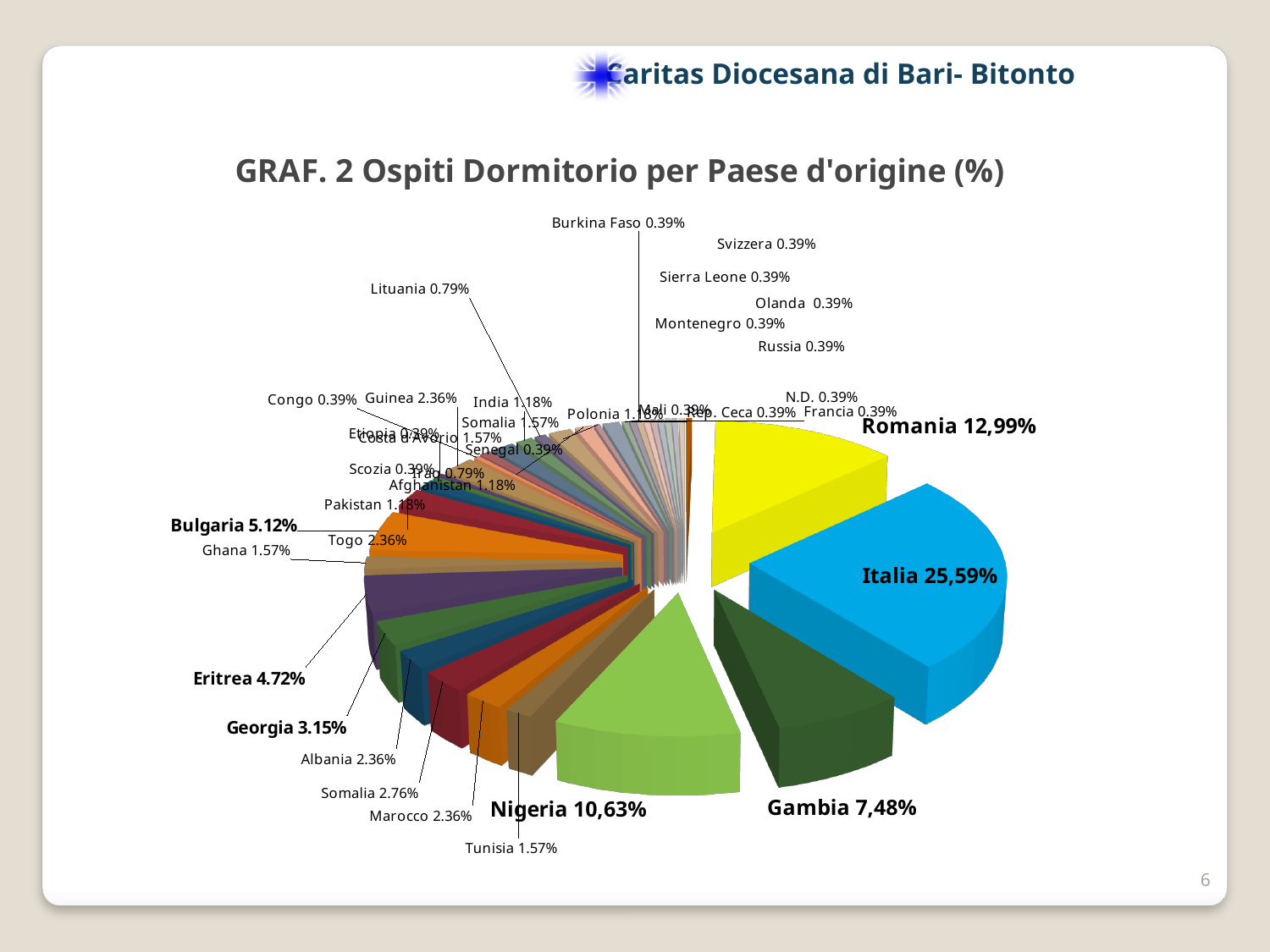
What is the difference between the shares of Italia and Romania? 12,60% What is the value shown for Nigeria? 10,63% Which country has the largest share of the pie? Italia What is the value shown for Romania? 12,99% What share of the pie does Italia have? 25,59% What is the title of the chart? GRAF. 2 Ospiti Dormitorio per Paese d'origine (%) What is the value shown for Gambia? 7,48% What is the value shown for Georgia? 3.15% What is the value shown for Eritrea? 4.72% What is the value shown for Lituania? 0.79% Which is larger, the share for Bulgaria or the share for Eritrea? Bulgaria What kind of chart is shown on the slide? pie chart